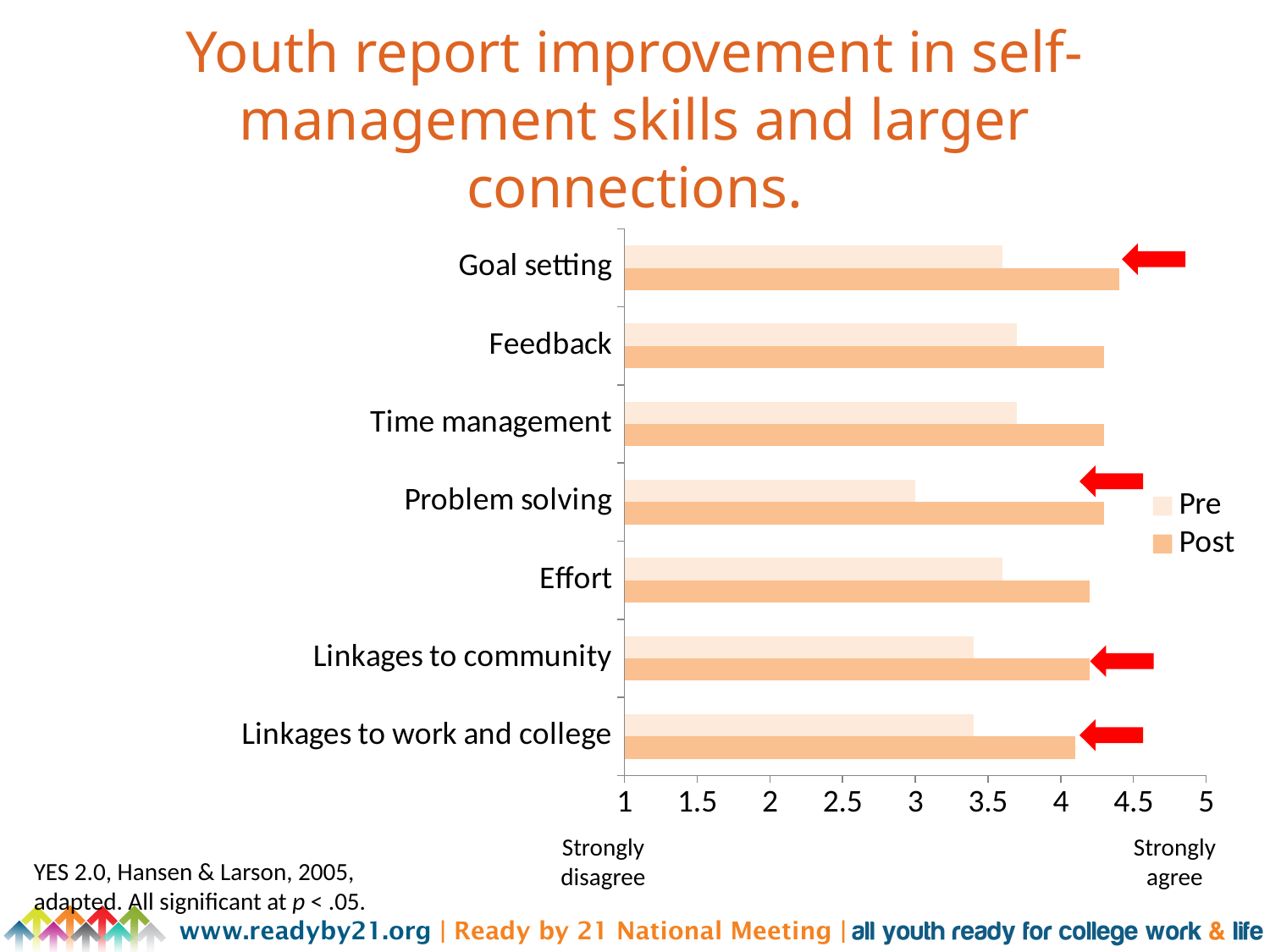
What label appears at the right end of the x axis, under the value 5? Strongly agree Is the Post value for Goal setting greater or less than 4? greater Is the Pre value for Time management greater or less than 3.5? greater For Problem solving, which is larger, the Pre value or the Post value? Post Is the Pre value for Problem solving greater or less than 3.5? less How many categories are plotted on the chart? 7 What kind of chart is shown on the slide? Bar chart Which is larger, the Pre value for Goal setting or the Pre value for Problem solving? Goal setting How many series does the legend list? 2 Which category has the lowest Pre value? Problem solving